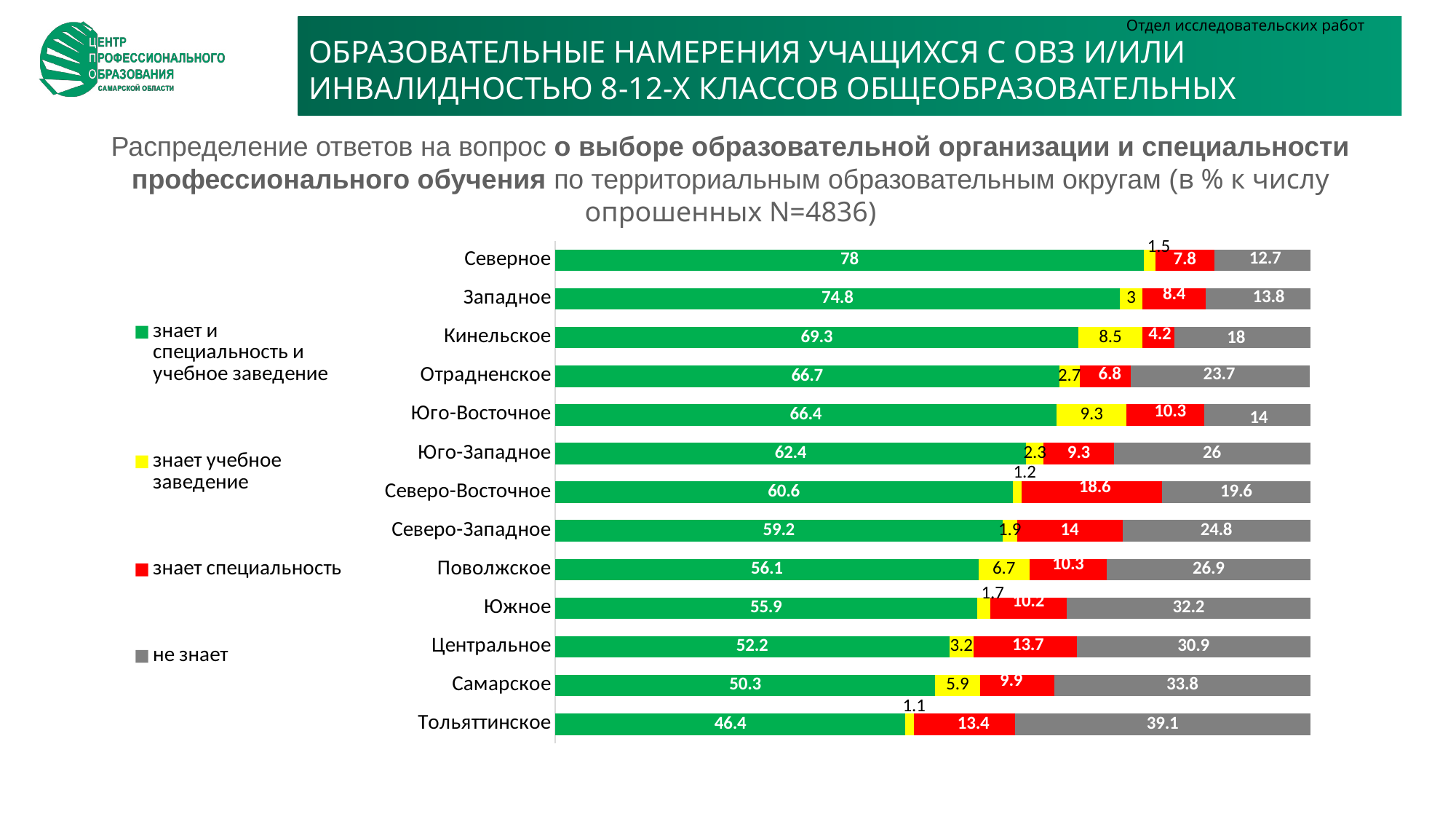
What is the value of "знает и специальность и учебное заведение" for Северное? 78 Which district has the highest value for "не знает"? Тольяттинское What is the total of the stacked bar for Западное? 100 What is the value of "знает учебное заведение" for Юго-Восточное? 9.3 What kind of chart is shown on the slide? Stacked bar chart What is the value of "не знает" for Тольяттинское? 39.1 Which is larger: the "знает специальность" value for Центральное or for Кинельское? Центральное What is the difference between the "не знает" values for Самарское and Северное? 21.1 How many series does the legend list? 4 Which district has the lowest value for "знает и специальность и учебное заведение"? Тольяттинское How many districts are shown on the chart? 13 What is the value of "знает специальность" for Северо-Восточное? 18.6